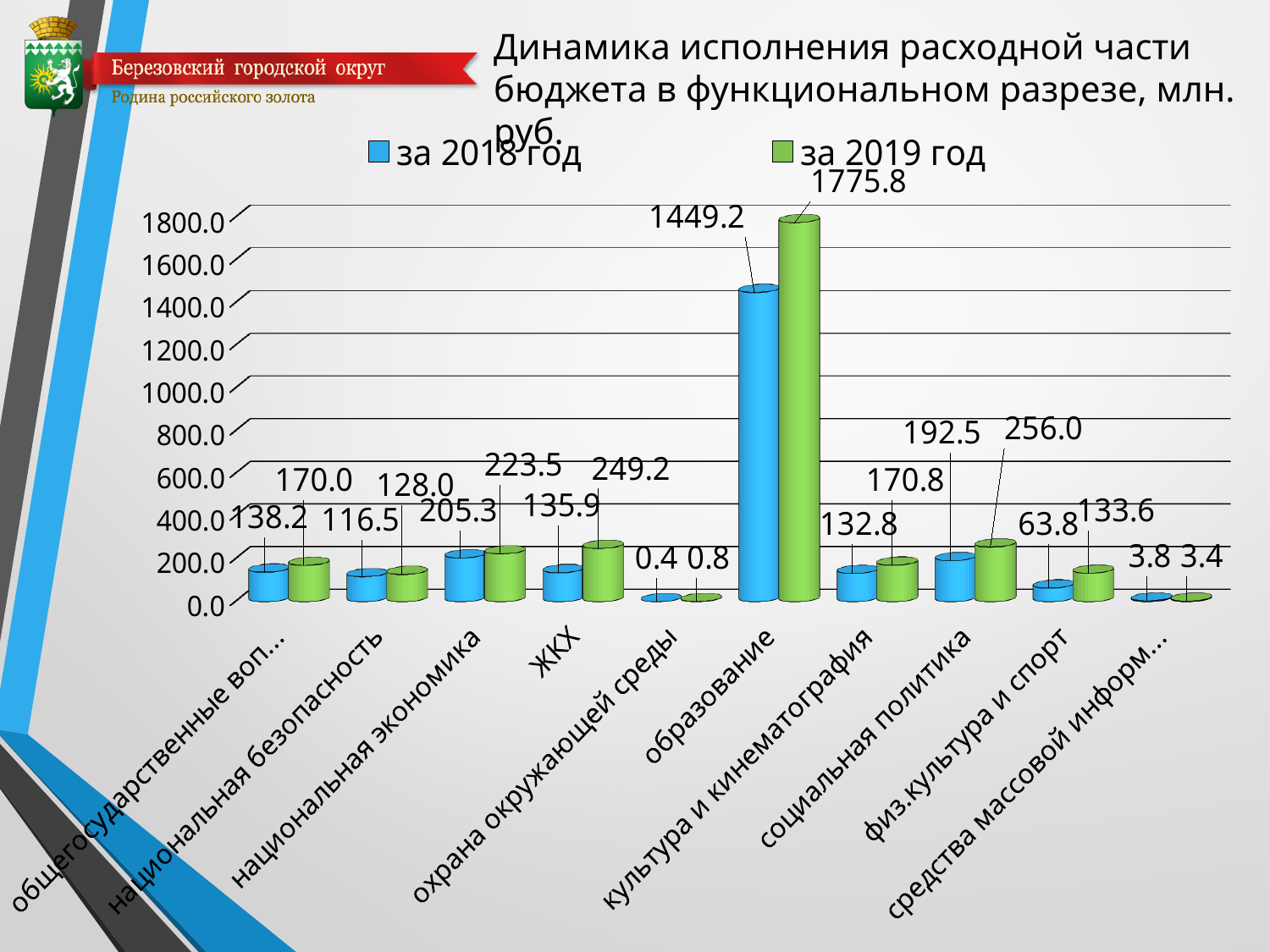
Which category has the lowest value for за 2019 год? охрана окружающей среды What is the difference between the за 2019 год and за 2018 год values for образование? 326.6 What kind of chart is shown on the slide? bar chart How many categories are shown on the x axis? 10 Which category has the highest value for за 2018 год? образование How many series does the legend list? 2 What is the difference between the за 2019 год and за 2018 год values for ЖКХ? 113.3 What is the value for социальная политика for за 2019 год? 256.0 What is the value for физ.культура и спорт for за 2018 год? 63.8 What is the value for ЖКХ for за 2018 год? 135.9 What is the value for образование for за 2019 год? 1775.8 Which is larger for национальная экономика: the value for за 2018 год or за 2019 год? за 2019 год